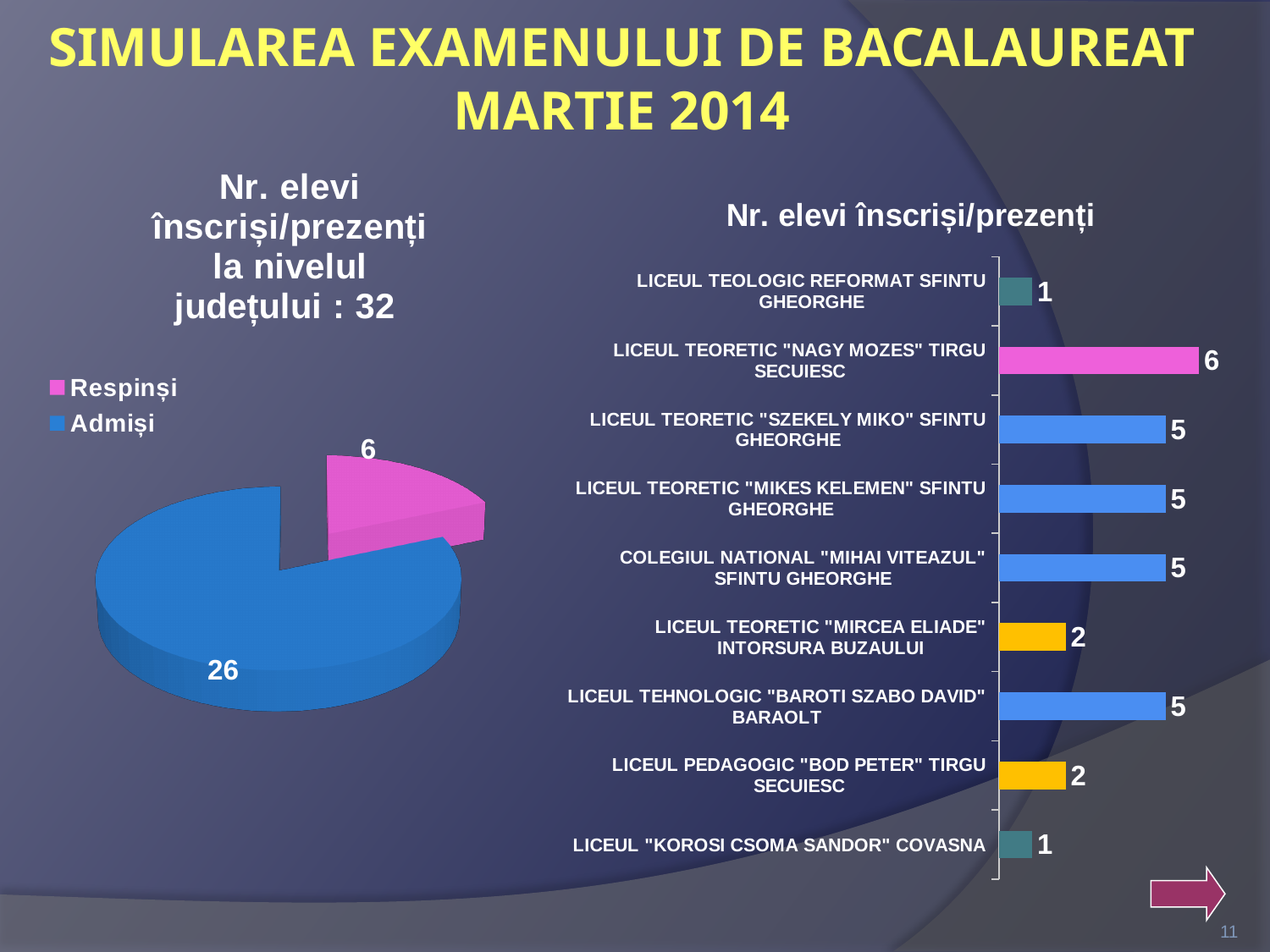
In the bar chart titled 'Nr. elevi înscriși/prezenți', which school has the highest value? LICEUL TEORETIC "NAGY MOZES" TIRGU SECUIESC In the pie chart on the left, what is the difference between Admiși and Respinși? 20 In the bar chart titled 'Nr. elevi înscriși/prezenți', how many schools are shown? 9 What type of chart is the chart on the right side of the slide? Bar chart In the bar chart titled 'Nr. elevi înscriși/prezenți', what is the value for LICEUL TEORETIC "NAGY MOZES" TIRGU SECUIESC? 6 In the pie chart on the left, how many entries does the legend list? 2 In the pie chart on the left, what share of the total do Respinși represent? 18.75% In the bar chart titled 'Nr. elevi înscriși/prezenți', what is the difference between LICEUL TEORETIC "NAGY MOZES" TIRGU SECUIESC and LICEUL TEORETIC "MIRCEA ELIADE" INTORSURA BUZAULUI? 4 In the pie chart on the left, what is the value for Admiși? 26 In the pie chart on the left, what is the value for Respinși? 6 In the bar chart titled 'Nr. elevi înscriși/prezenți', which is larger: LICEUL TEHNOLOGIC "BAROTI SZABO DAVID" BARAOLT or LICEUL "KOROSI CSOMA SANDOR" COVASNA? LICEUL TEHNOLOGIC "BAROTI SZABO DAVID" BARAOLT In the bar chart titled 'Nr. elevi înscriși/prezenți', what is the value for LICEUL PEDAGOGIC "BOD PETER" TIRGU SECUIESC? 2